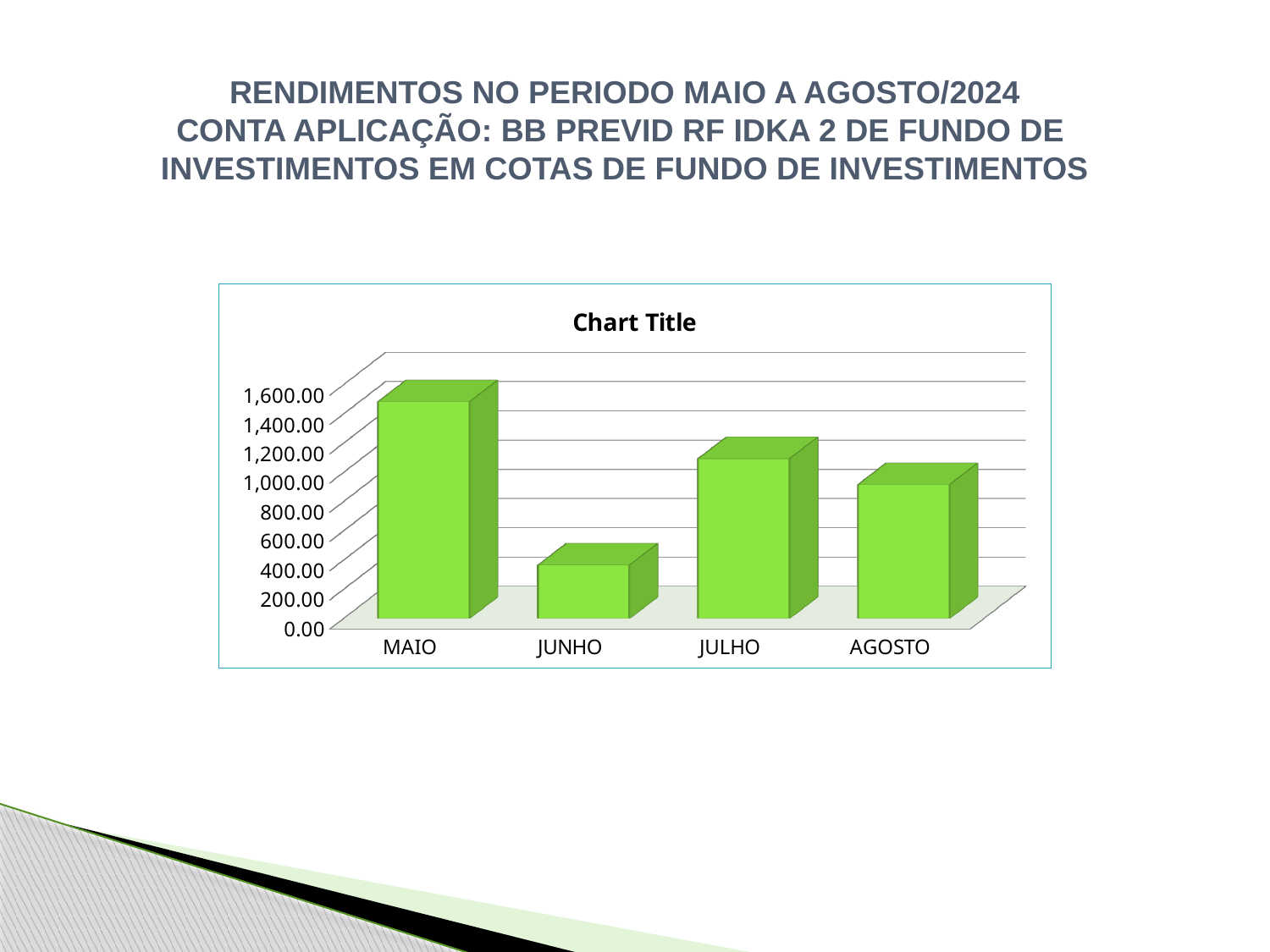
What kind of chart is shown on the slide? bar chart Is the value for AGOSTO greater or less than 1,200.00? less What title is printed above the chart's plot area? Chart Title Does the value rise or fall from MAIO to JUNHO? fall Which month has the lowest value in the chart? JUNHO How many categories are shown on the x axis of the chart? 4 Which has the larger value, JULHO or AGOSTO? JULHO Is the value for MAIO greater or less than 1,200.00? greater Which month has the highest value in the chart? MAIO Which has the larger value, MAIO or JULHO? MAIO Is the value for JULHO greater or less than 800.00? greater